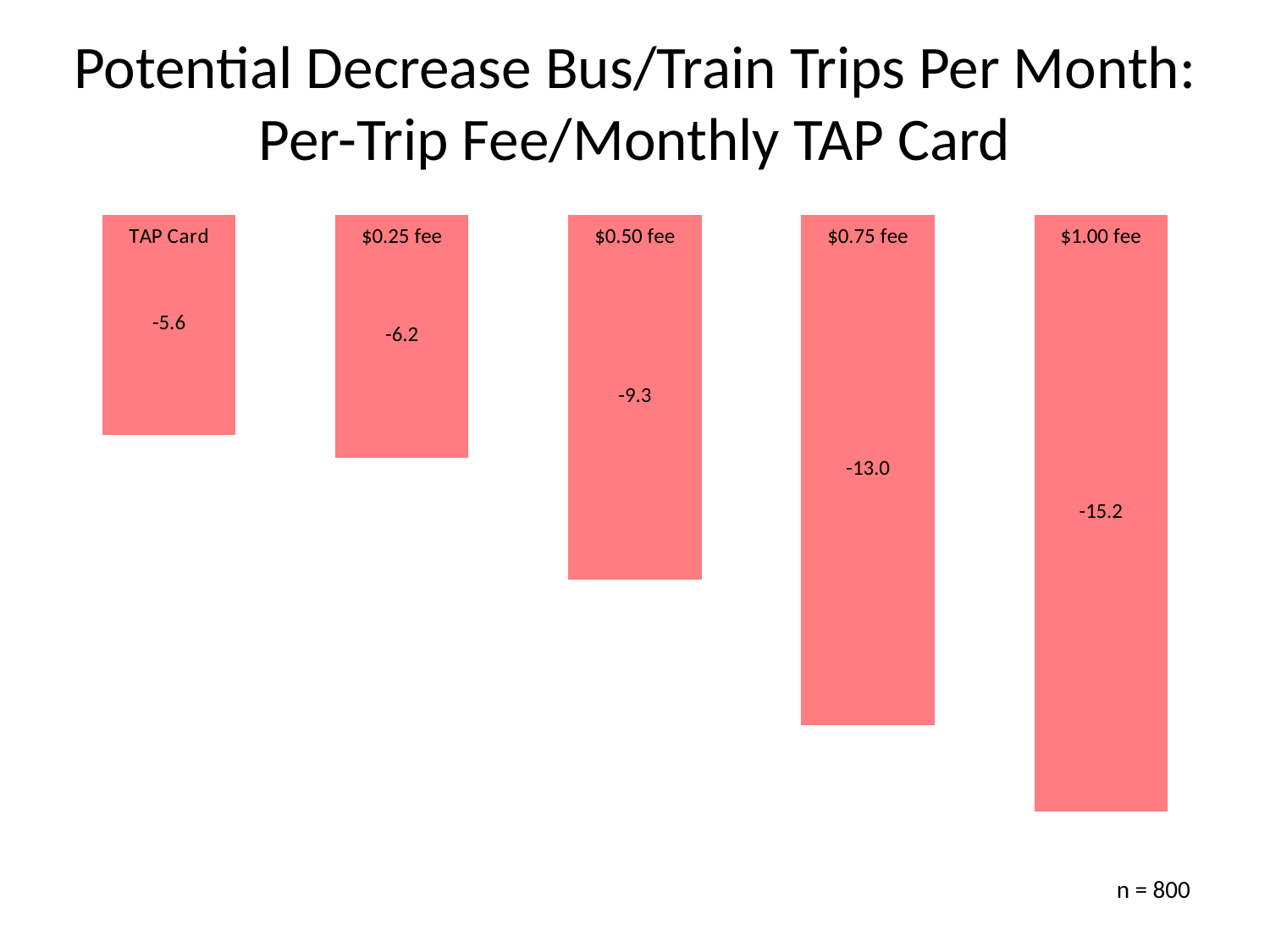
Which category shows the smallest decrease in trips per month? TAP Card What is the value shown for the TAP Card bar? -5.6 What is the value shown for the $0.50 fee bar? -9.3 By how much does the decrease for the $1.00 fee exceed the decrease for the TAP Card? 9.6 What is the value shown for the $1.00 fee bar? -15.2 Which shows a larger decrease, the $0.25 fee or the $0.50 fee? $0.50 fee What is the value shown for the $0.75 fee bar? -13.0 What kind of chart is shown on the slide? Bar chart What is the difference between the values for the $0.75 fee and the $0.50 fee? 3.7 Moving from left to right across the chart, do the values become more negative or less negative? More negative Which category shows the largest decrease in trips per month? $1.00 fee How many categories are shown in the chart? 5